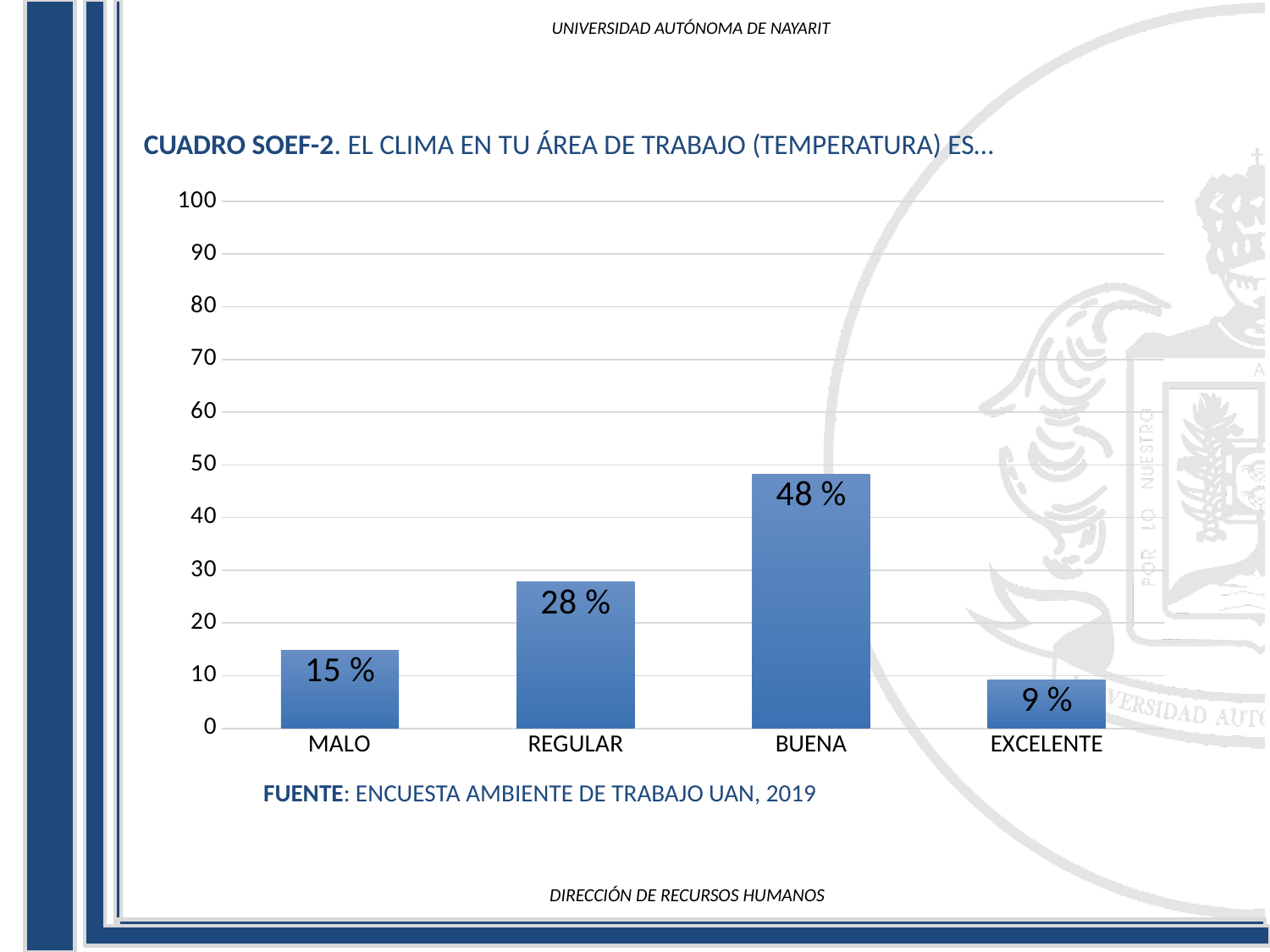
What is the source cited below the chart? ENCUESTA AMBIENTE DE TRABAJO UAN, 2019 What is the difference between the values for BUENA and REGULAR? 20 % How many categories are shown on the x axis? 4 What is the maximum value shown on the y axis? 100 What is the value for MALO? 15 % Which is larger, the value for MALO or the value for REGULAR? REGULAR Which category has the lowest value? EXCELENTE What is the value for EXCELENTE? 9 % Is the value for REGULAR greater or less than 30? less Which category has the highest value? BUENA What kind of chart is shown on the slide? bar chart What is the value for BUENA? 48 %